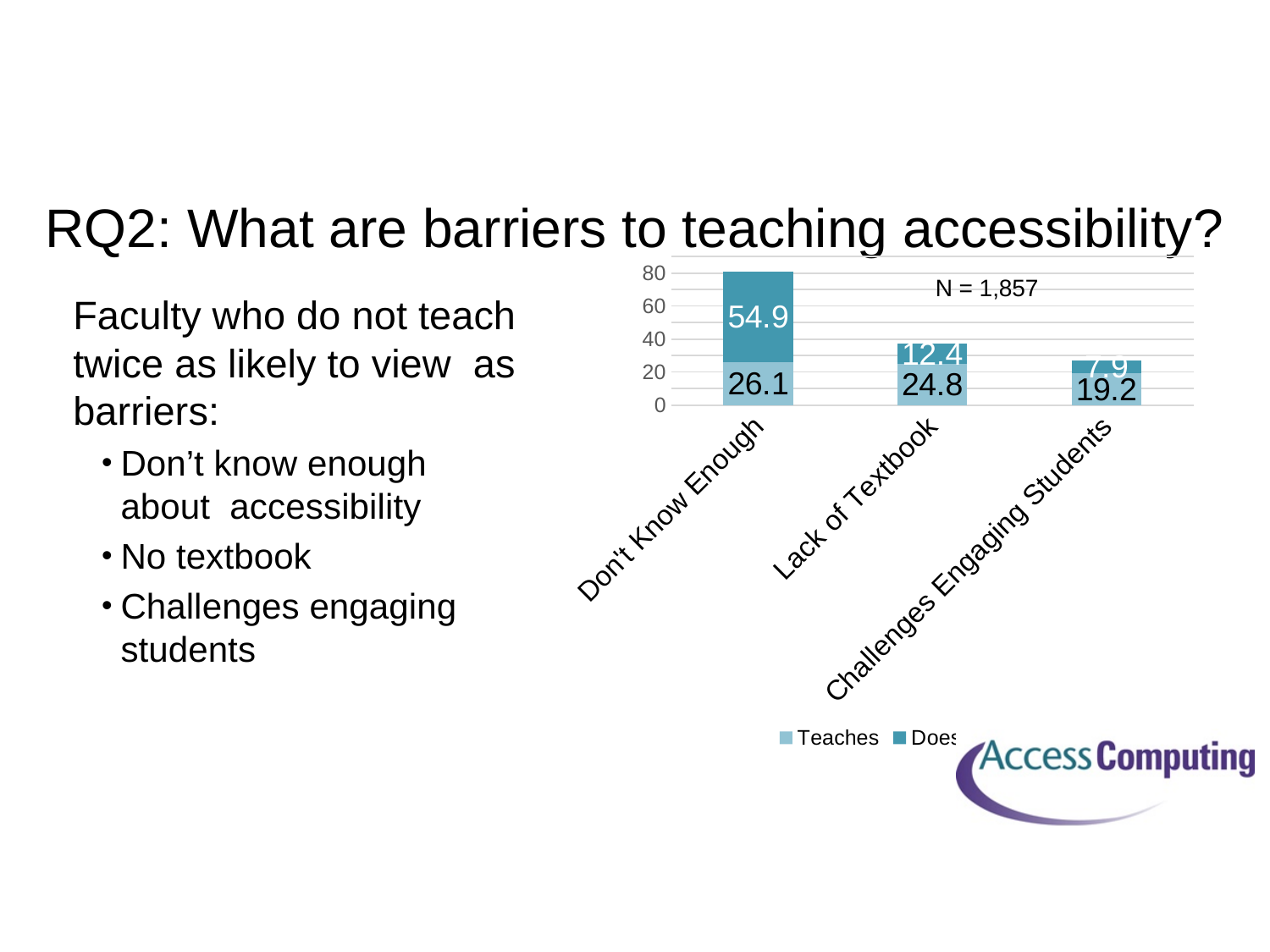
How many series does the legend list? 2 What sample size (N) is shown on the chart? N = 1,857 What kind of chart is shown on the slide? Stacked bar chart What is the value of the darker blue upper segment for Don't Know Enough? 54.9 What is the Teaches value for Lack of Textbook? 24.8 Which category has the lowest Teaches value? Challenges Engaging Students What is the Teaches value for Challenges Engaging Students? 19.2 How many categories are shown on the x axis? 3 What is the value of the darker blue upper segment for Lack of Textbook? 12.4 What is the Teaches value for Don't Know Enough? 26.1 What is the total of the stacked bar for Lack of Textbook? 37.2 What is the difference between the darker blue segment and the Teaches segment for Don't Know Enough? 28.8